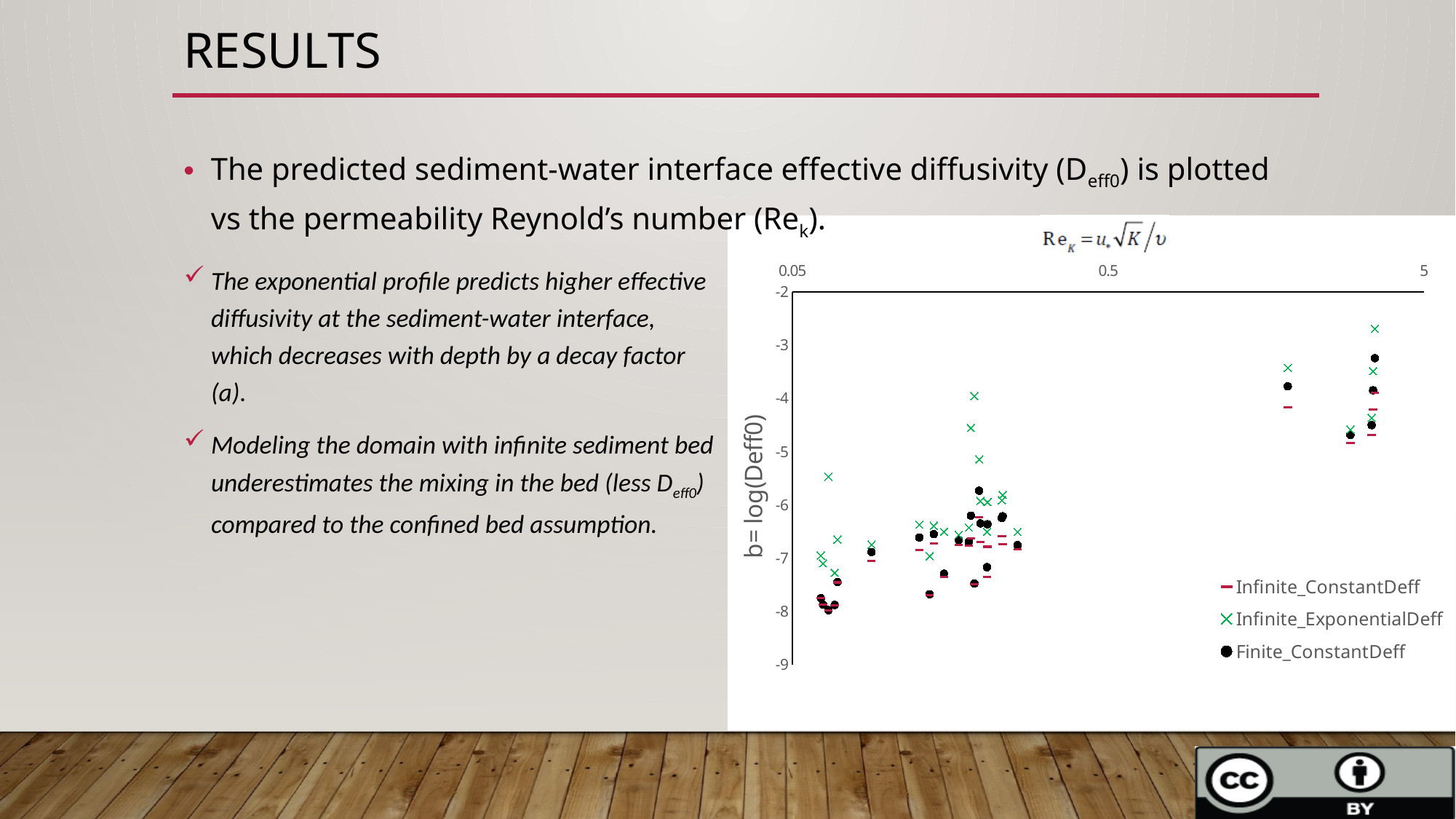
At the rightmost x position (near 5), which is higher: the Infinite_ExponentialDeff point or the Finite_ConstantDeff point? Infinite_ExponentialDeff What is the lowest tick value shown on the vertical axis? -9 How many series does the chart legend list? 3 Is the highest plotted point on the chart greater or less than -3? greater Which series contains the highest plotted point on the chart? Infinite_ExponentialDeff What is the label of the vertical axis of the chart? b= log(Deff) Do the plotted values generally rise or fall as the permeability Reynolds number increases along the x axis? rise Are the lowest plotted points near the left of the chart greater or less than -7? less What kind of chart is shown on the slide? Scatter chart Are the points plotted near x = 0.5 greater or less than -5 on the vertical axis? less Which series is marked with green X markers in the legend? Infinite_ExponentialDeff